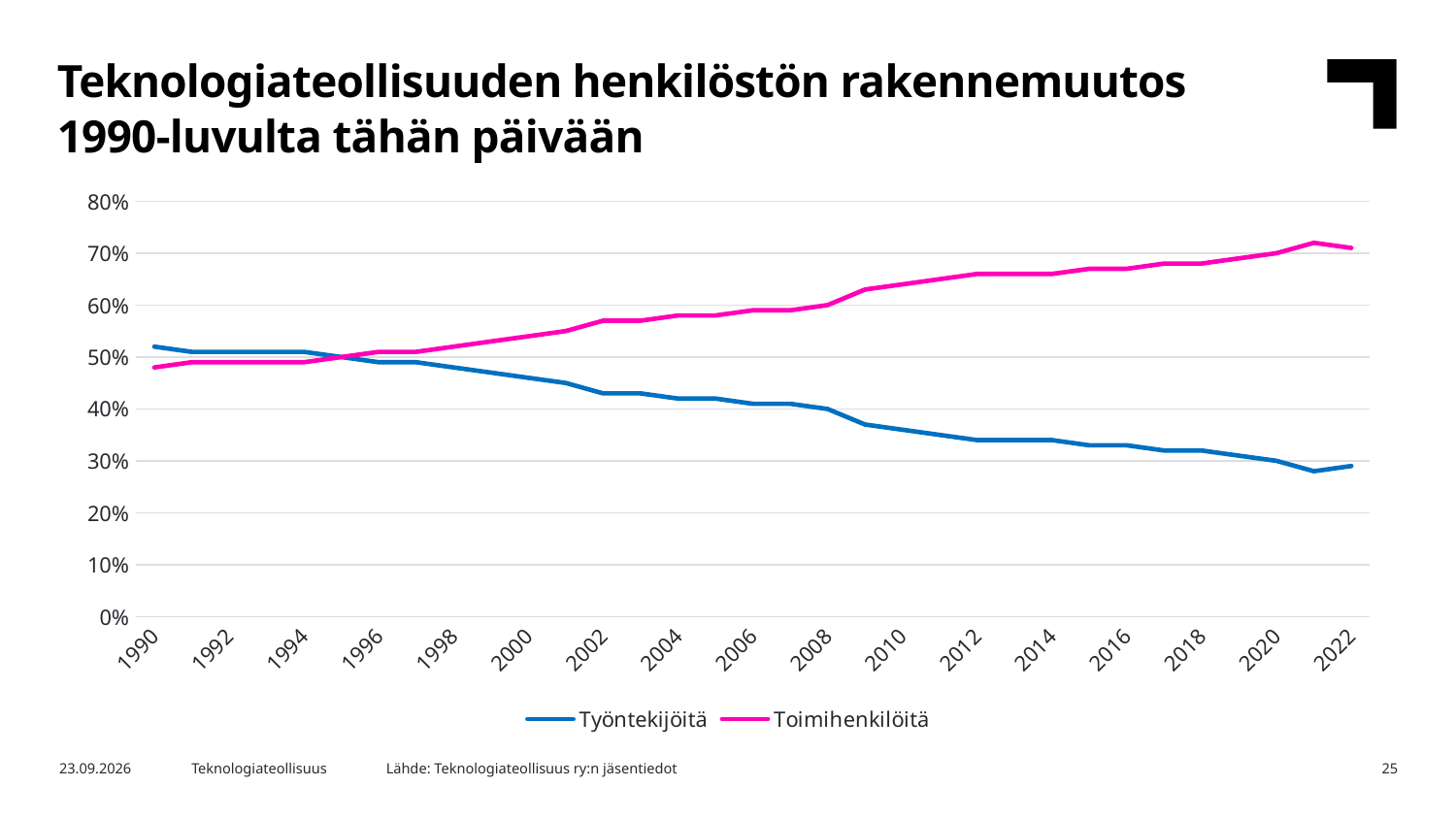
Does the Työntekijöitä line rise or fall from 1990 to 2022? Fall What is the title of the chart on the slide? Teknologiateollisuuden henkilöstön rakennemuutos 1990-luvulta tähän päivään In 1990, which series has the higher value, Työntekijöitä or Toimihenkilöitä? Työntekijöitä What are the two series named in the legend? Työntekijöitä and Toimihenkilöitä How many series does the legend list? 2 What kind of chart is shown on the slide? Line chart Is the value for Työntekijöitä in 2022 greater or less than 40%? less Is the value for Toimihenkilöitä in 1990 greater or less than 50%? less Is the value for Työntekijöitä in 1990 greater or less than 50%? greater In 2022, which series has the higher value, Työntekijöitä or Toimihenkilöitä? Toimihenkilöitä Does the Toimihenkilöitä line rise or fall from 1990 to 2022? Rise